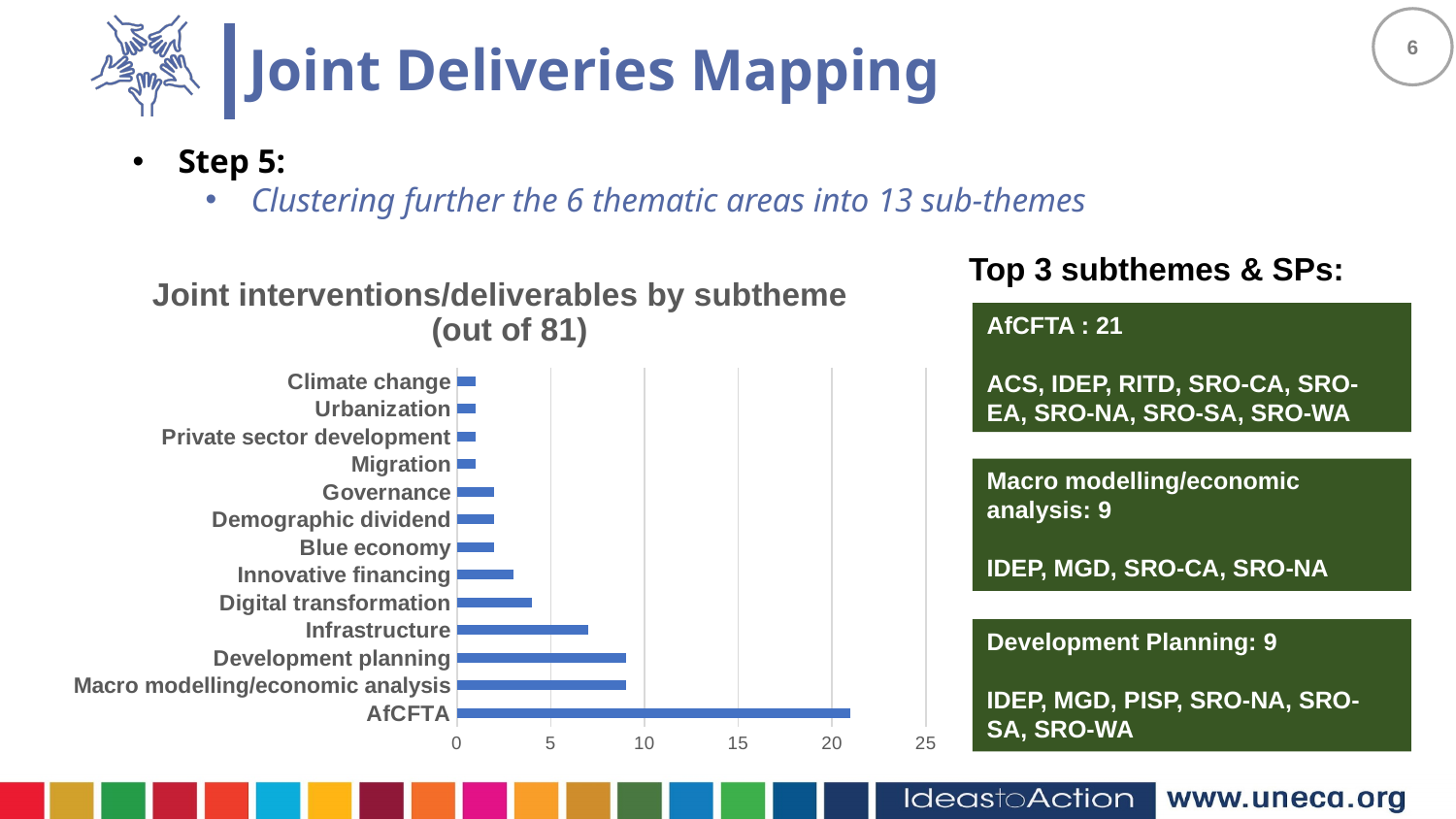
How many subthemes are plotted in the chart? 13 How many joint interventions/deliverables does Macro modelling/economic analysis have? 9 Which subtheme has the highest number of joint interventions/deliverables? AfCFTA Is the value for Infrastructure greater or less than 5? greater Which has a larger value, Infrastructure or Digital transformation? Infrastructure What is the title of the chart? Joint interventions/deliverables by subtheme (out of 81) Is the value for AfCFTA greater or less than 20? greater What is the highest value shown on the chart's horizontal axis? 25 What kind of chart is shown on the slide? bar chart Is the value for Digital transformation greater or less than 5? less What is the difference between the values for AfCFTA and Development planning? 12 How many joint interventions/deliverables does AfCFTA have? 21